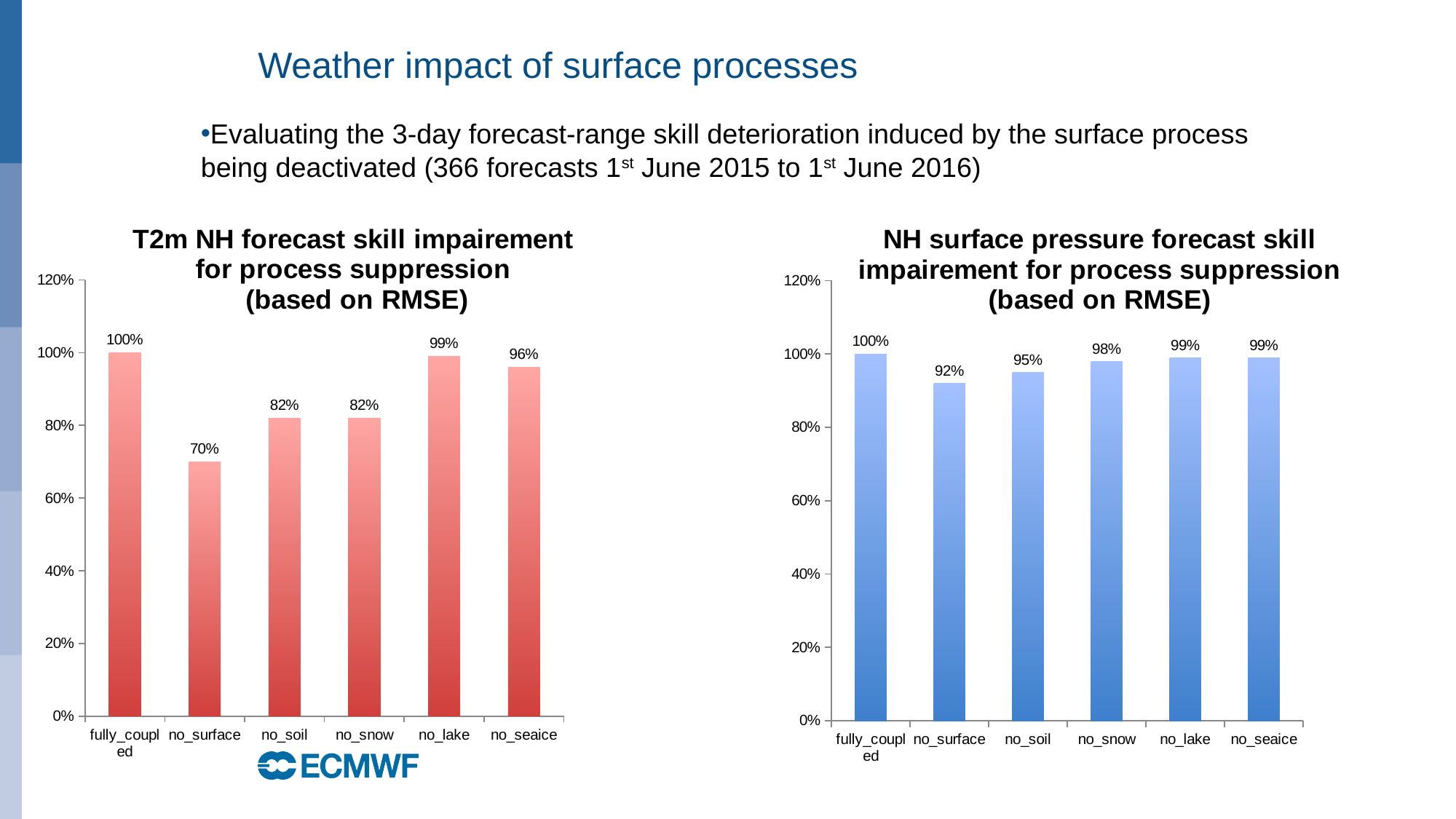
In the T2m NH forecast skill impairement chart, what is the value for no_surface? 70% In the NH surface pressure forecast skill impairement chart, what is the value for no_soil? 95% How many categories are shown in the NH surface pressure forecast skill impairement chart? 6 In the T2m NH forecast skill impairement chart, which is larger, the value for no_lake or the value for no_soil? no_lake In the T2m NH forecast skill impairement chart, is the value for no_surface greater or less than 80%? less What colour are the bars in the NH surface pressure forecast skill impairement chart? blue In the NH surface pressure forecast skill impairement chart, what is the difference between the values for no_snow and no_surface? 6% In the T2m NH forecast skill impairement chart, which category has the lowest value? no_surface What kind of chart is the T2m NH forecast skill impairement chart? bar chart In the NH surface pressure forecast skill impairement chart, which category has the lowest value? no_surface In the T2m NH forecast skill impairement chart, which category has the highest value? fully_coupled In the T2m NH forecast skill impairement chart, what is the difference between the values for fully_coupled and no_surface? 30%